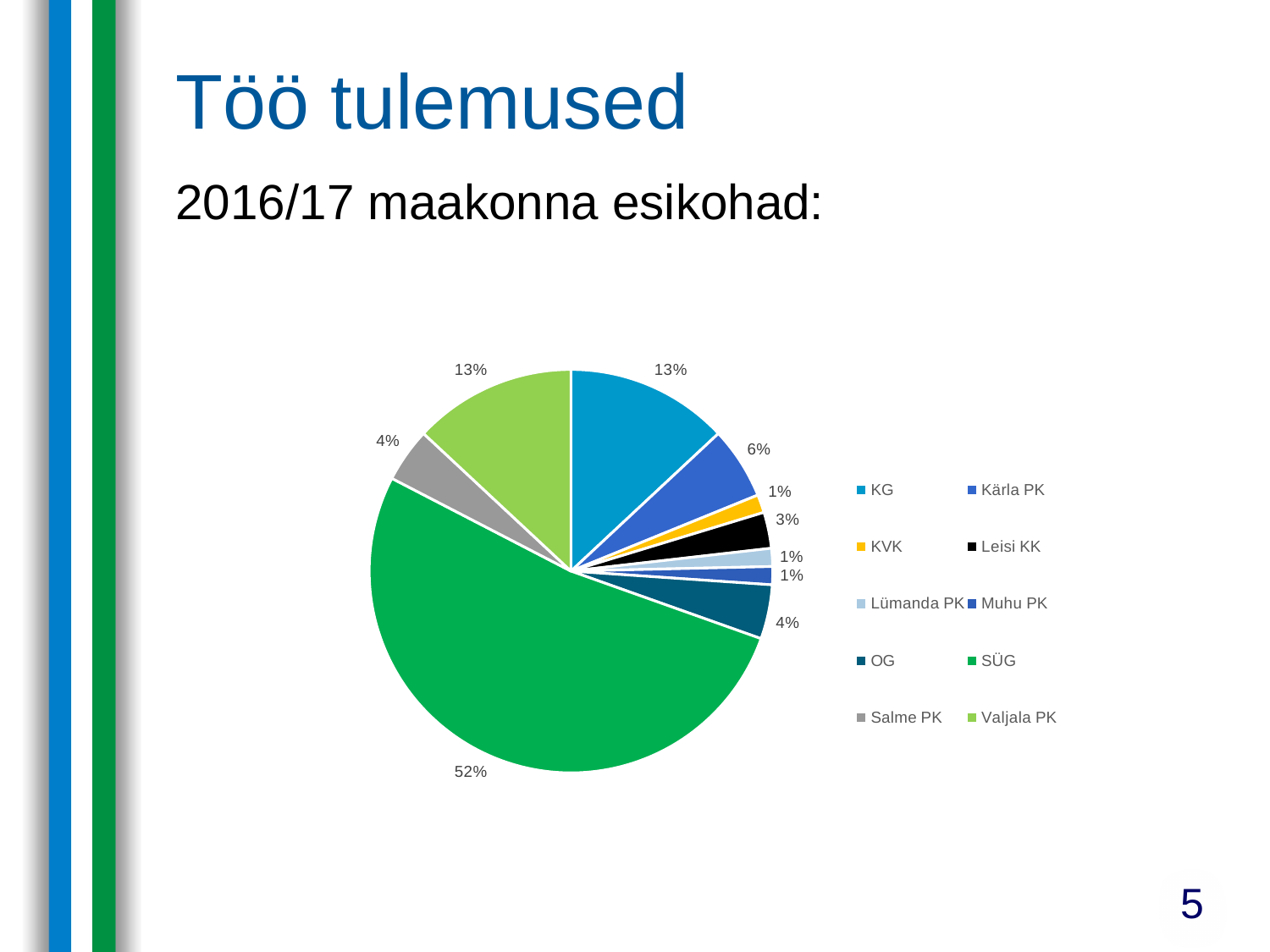
What share of the pie does SÜG have? 52% What is the difference in percentage points between the KG slice and the Kärla PK slice? 7 What kind of chart is shown on the slide? pie chart Which category has the largest slice of the pie? SÜG What share of the pie does KG have? 13% What share of the pie does Kärla PK have? 6% Which is larger, the slice for Kärla PK or the slice for Leisi KK? Kärla PK What colour is the SÜG slice in the pie chart? green How many categories does the legend of the pie chart list? 10 What is the difference in percentage points between the SÜG slice and the Valjala PK slice? 39